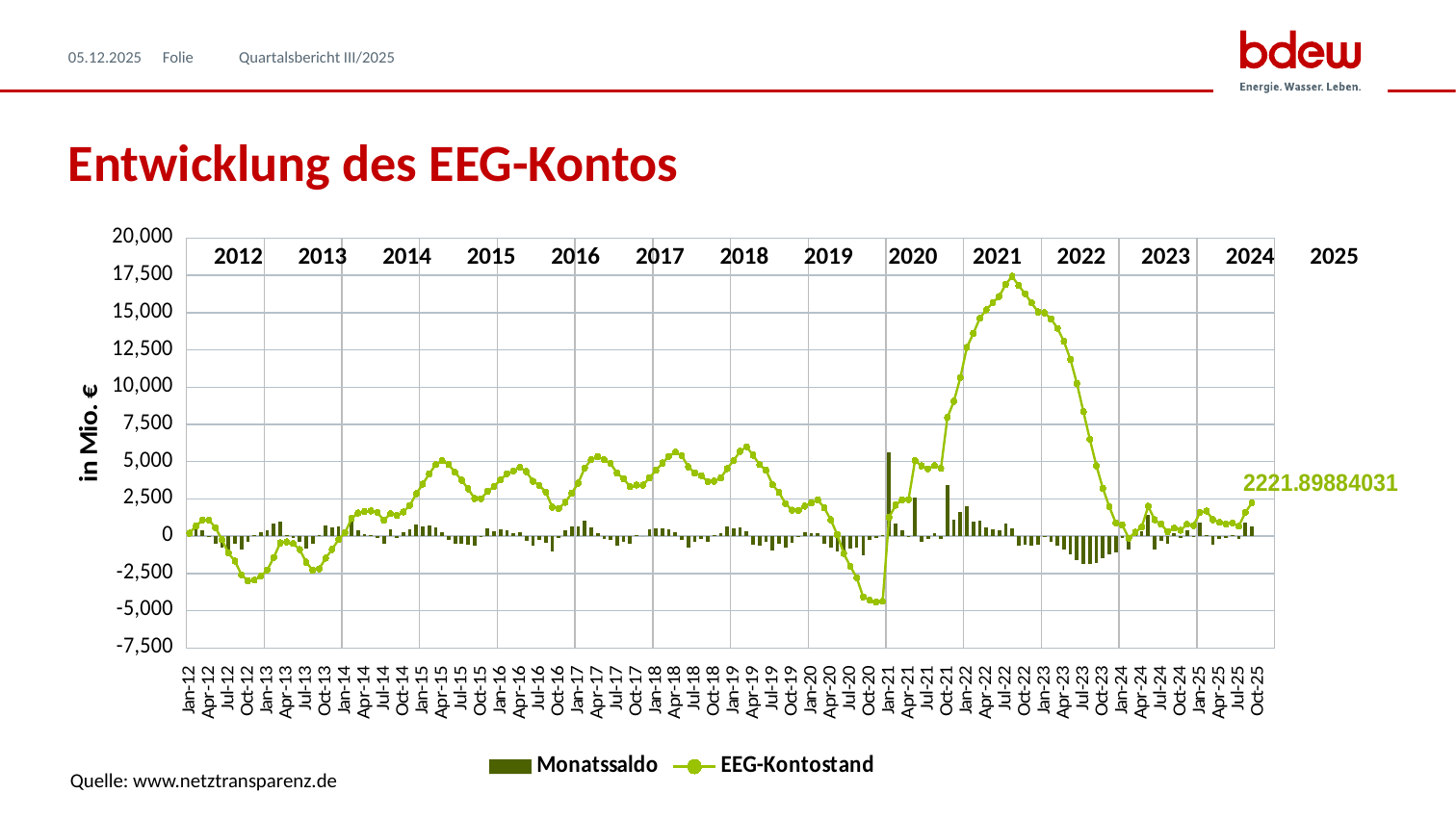
Is the EEG-Kontostand in Jul-22 greater or less than 15,000? greater In which year does the EEG-Kontostand line reach its highest point? 2022 What is the label on the vertical axis of the chart? in Mio. € Is the EEG-Kontostand in Apr-15 greater or less than 2,500? greater Is the EEG-Kontostand in Oct-20 greater or less than -2,500? less Does the EEG-Kontostand rise or fall between Jan-21 and Jul-22? rise What value is printed as the data label at the end of the EEG-Kontostand line? 2221.89884031 How many series does the legend list? 2 Does the EEG-Kontostand rise or fall between Jul-22 and Jan-24? fall Is the EEG-Kontostand higher in Jul-22 or in Jul-19? Jul-22 What kind of chart is shown on the slide? A combined bar and line chart